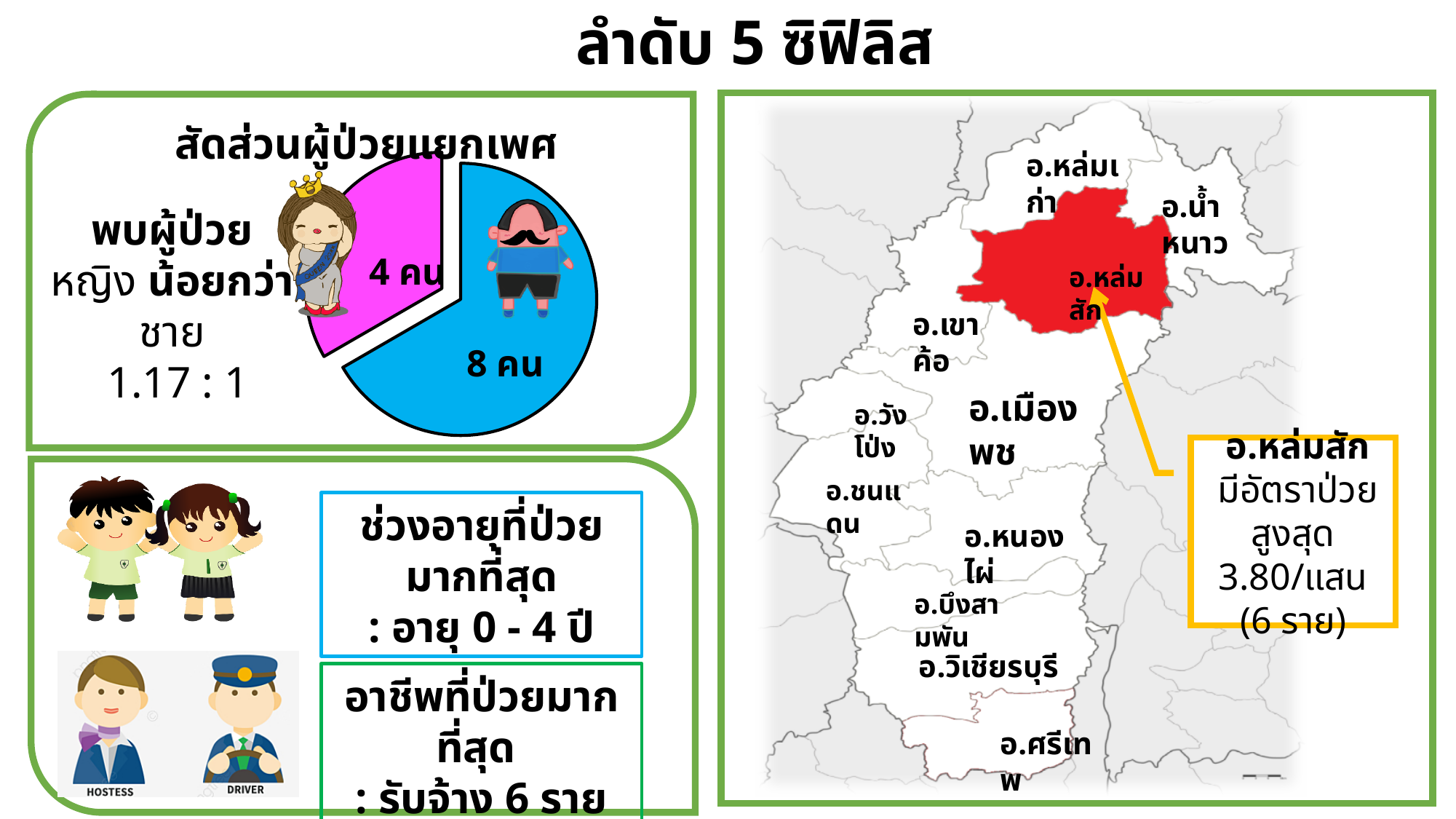
What colour is the slice labelled 8 คน in the pie chart? blue In the pie chart สัดส่วนผู้ป่วยแยกเพศ, what is the total of the two slices? 12 คน In the pie chart สัดส่วนผู้ป่วยแยกเพศ, what fraction of the whole does the blue slice (8 คน) represent? 2/3 In the pie chart สัดส่วนผู้ป่วยแยกเพศ, what fraction of the whole does the pink slice (4 คน) represent? 1/3 In the pie chart สัดส่วนผู้ป่วยแยกเพศ, what value is printed on the pink slice? 4 คน In the pie chart สัดส่วนผู้ป่วยแยกเพศ, what is the difference between the blue slice and the pink slice? 4 คน What kind of chart is shown in the top-left panel titled สัดส่วนผู้ป่วยแยกเพศ? pie chart In the pie chart สัดส่วนผู้ป่วยแยกเพศ, how many slices are there? 2 What is the title of the pie chart in the top-left panel? สัดส่วนผู้ป่วยแยกเพศ In the pie chart สัดส่วนผู้ป่วยแยกเพศ, which slice is larger, the pink one or the blue one? the blue one In the pie chart สัดส่วนผู้ป่วยแยกเพศ, what value is printed on the blue slice? 8 คน In the pie chart สัดส่วนผู้ป่วยแยกเพศ, which slice has the smallest value? the pink slice (4 คน)